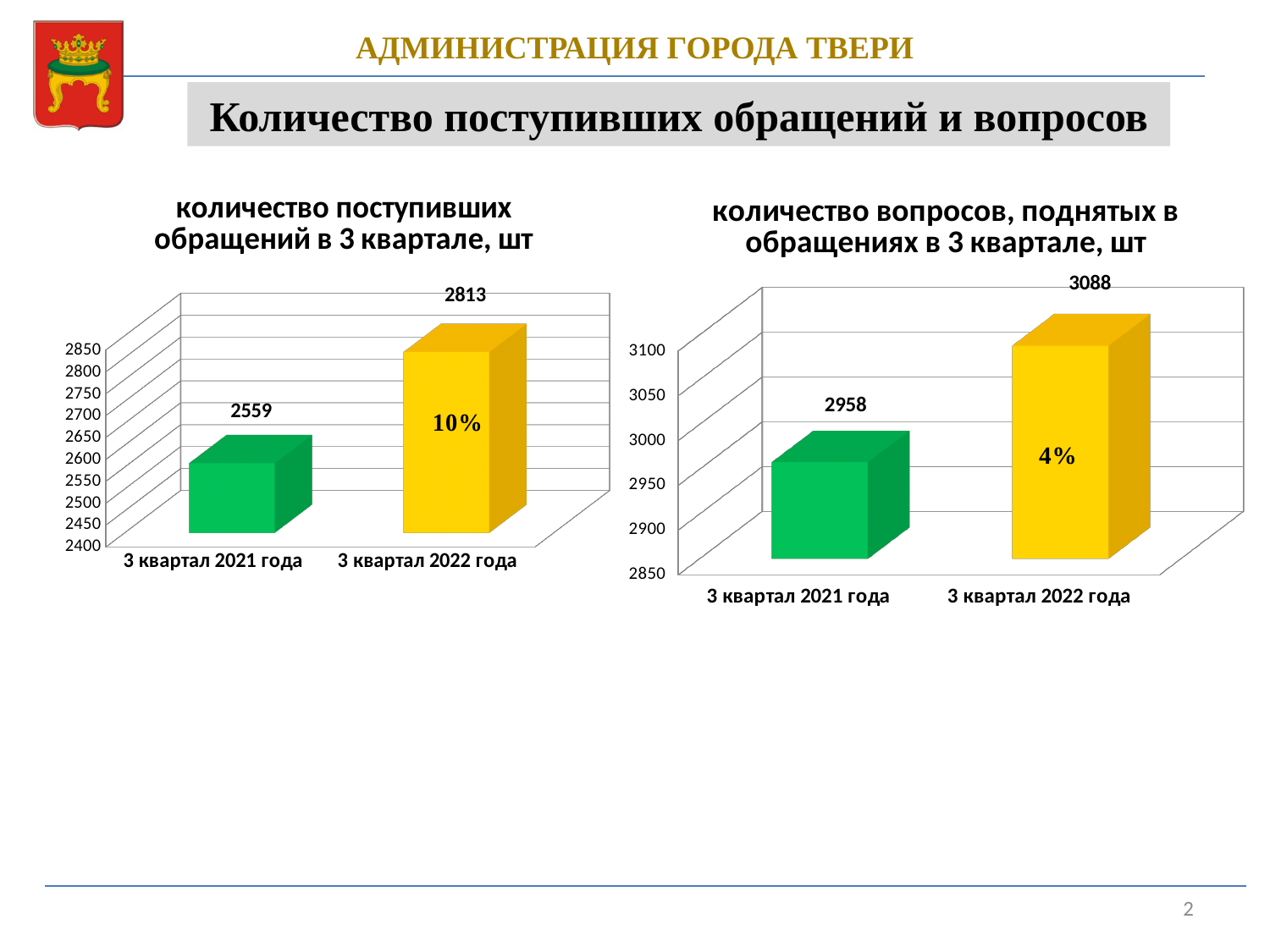
In the right chart (количество вопросов, поднятых в обращениях в 3 квартале, шт), what is the value for 3 квартал 2022 года? 3088 In the right chart (количество вопросов, поднятых в обращениях в 3 квартале, шт), what is the value for 3 квартал 2021 года? 2958 What kind of chart is the right chart (количество вопросов, поднятых в обращениях в 3 квартале, шт)? bar chart In the left chart, what is the difference between the values for 3 квартал 2022 года and 3 квартал 2021 года? 254 In the left chart, which category has the highest value? 3 квартал 2022 года In the left chart (количество поступивших обращений в 3 квартале, шт), what is the value for 3 квартал 2022 года? 2813 In the right chart, what is the difference between the values for 3 квартал 2022 года and 3 квартал 2021 года? 130 How many categories are shown in the left chart? 2 In the left chart (количество поступивших обращений в 3 квартале, шт), what is the value for 3 квартал 2021 года? 2559 In the left chart, what percentage label is printed on the bar for 3 квартал 2022 года? 10% In the right chart, which category has the lowest value? 3 квартал 2021 года In the right chart, is the value for 3 квартал 2021 года greater or less than 3000? less